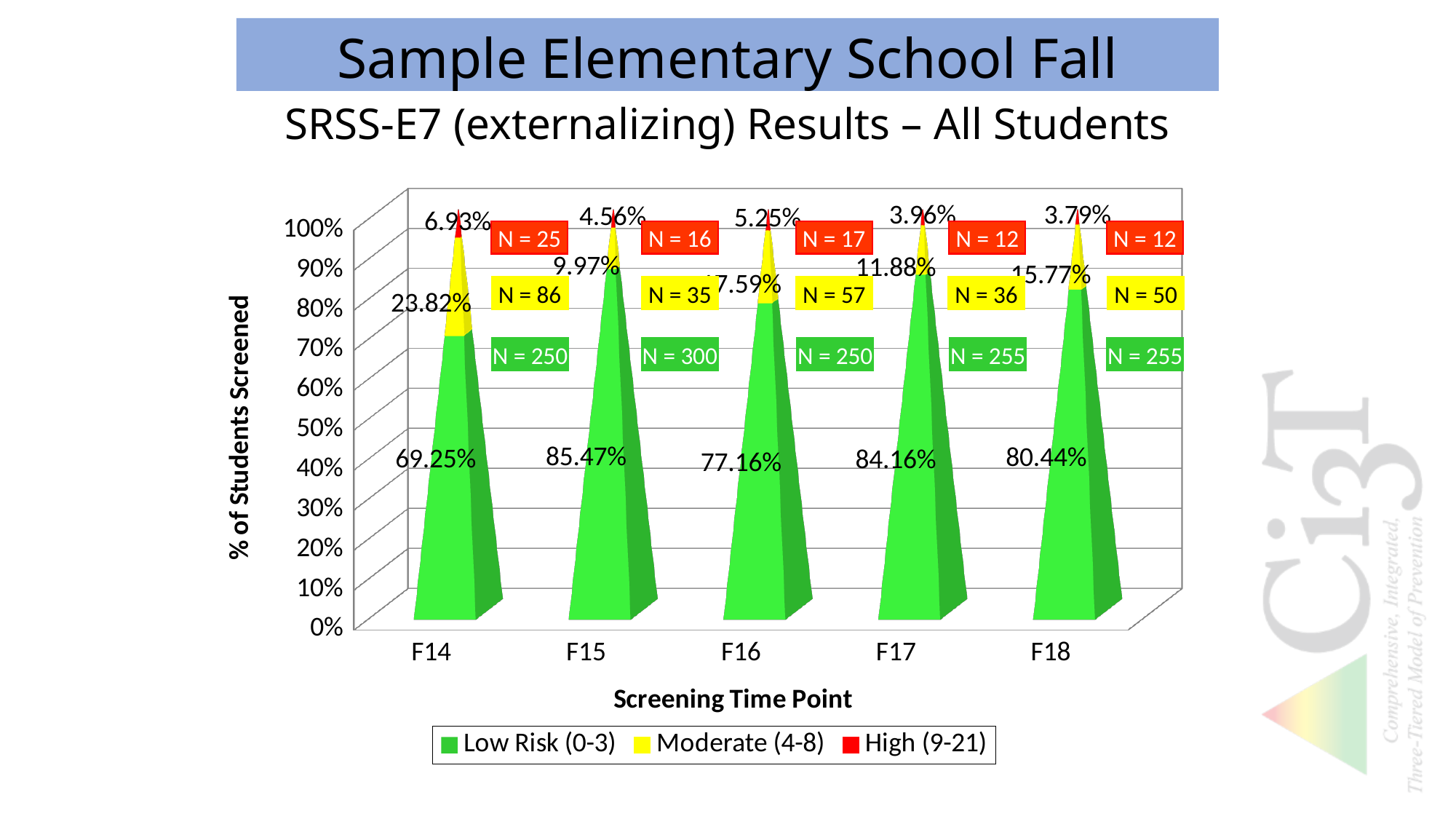
What is the title of the y axis? % of Students Screened What is the Moderate (4-8) percentage for F17? 11.88% Which screening time point has the lowest High (9-21) percentage? F18 How many series does the legend list? 3 How many screening time points are shown on the x axis? 5 Which screening time point has the highest Low Risk (0-3) percentage? F15 Which has a larger Moderate (4-8) percentage, F14 or F16? F14 What is the Low Risk (0-3) percentage for F14? 69.25% What kind of chart is shown on the slide? Stacked bar chart What N value is shown in the green box for F15? N = 300 What is the High (9-21) percentage for F18? 3.79% What is the difference between the Low Risk (0-3) percentages for F15 and F14? 16.22 percentage points